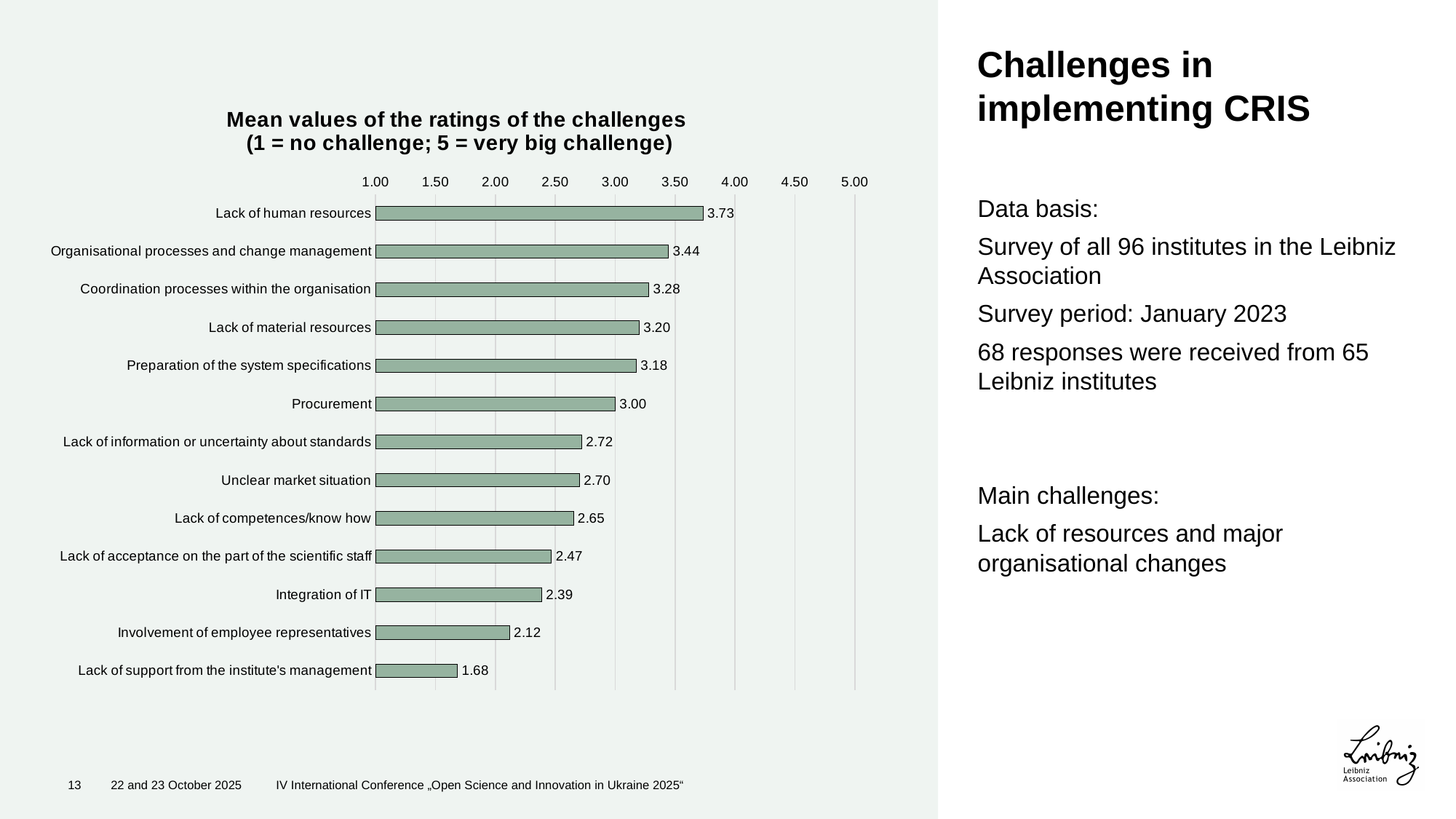
Is the mean rating for Involvement of employee representatives greater or less than 2.50? less Which has a higher mean rating: Unclear market situation or Lack of acceptance on the part of the scientific staff? Unclear market situation Which challenge has the highest mean rating? Lack of human resources How many challenges are shown in the chart? 13 What type of chart is shown on the slide? Bar chart What is the difference between the mean ratings for Lack of human resources and Lack of support from the institute's management? 2.05 Which challenge has the lowest mean rating? Lack of support from the institute's management What is the title of the chart? Mean values of the ratings of the challenges (1 = no challenge; 5 = very big challenge) What is the difference between the mean ratings for Organisational processes and change management and Lack of material resources? 0.24 What is the mean rating for Lack of human resources? 3.73 What is the mean rating for Procurement? 3.00 What is the mean rating for Integration of IT? 2.39